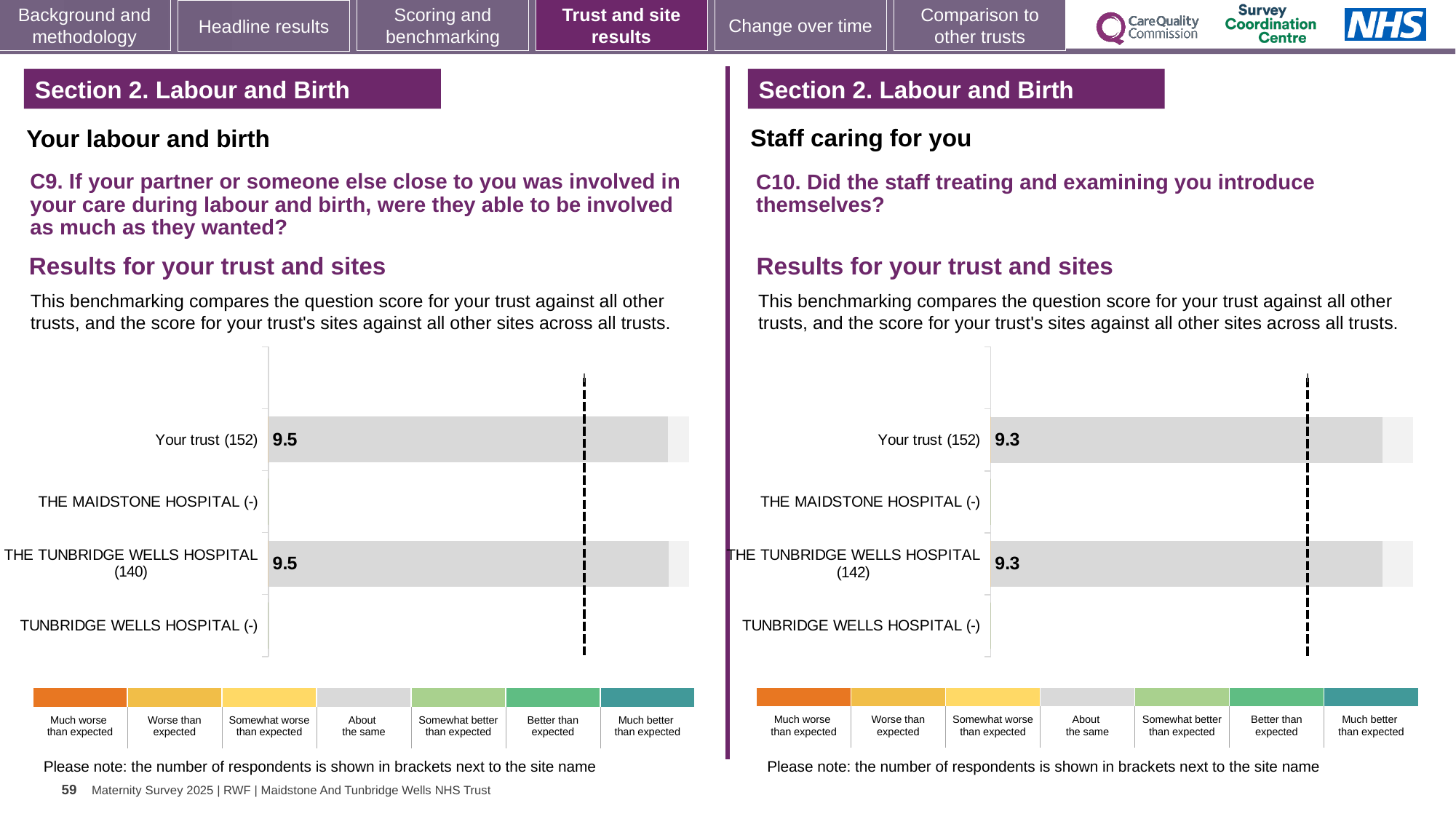
How many categories does the colour key below the right chart (C10) list, from 'Much worse than expected' to 'Much better than expected'? 7 On the right chart (C10), how many respondents are shown in brackets for Your trust? 152 What kind of chart is used on the left (C9) to show the results for your trust and sites? Bar chart On the right chart (C10), how many site or trust categories are listed on the vertical axis? 4 On the left chart (C9), which categories have no bar plotted? The Maidstone Hospital and Tunbridge Wells Hospital On the left chart (C9), how many respondents are shown in brackets for The Tunbridge Wells Hospital? 140 On the left chart (C9), what is the score for The Tunbridge Wells Hospital? 9.5 On the left chart (C9), what is the difference between the score for Your trust and the score for The Tunbridge Wells Hospital? 0 On the right chart (C10), what is the score for Your trust? 9.3 On the right chart (C10), how many respondents are shown in brackets for The Tunbridge Wells Hospital? 142 On the left chart (C9), what is the score for Your trust? 9.5 On the right chart (C10), what is the score for The Tunbridge Wells Hospital? 9.3